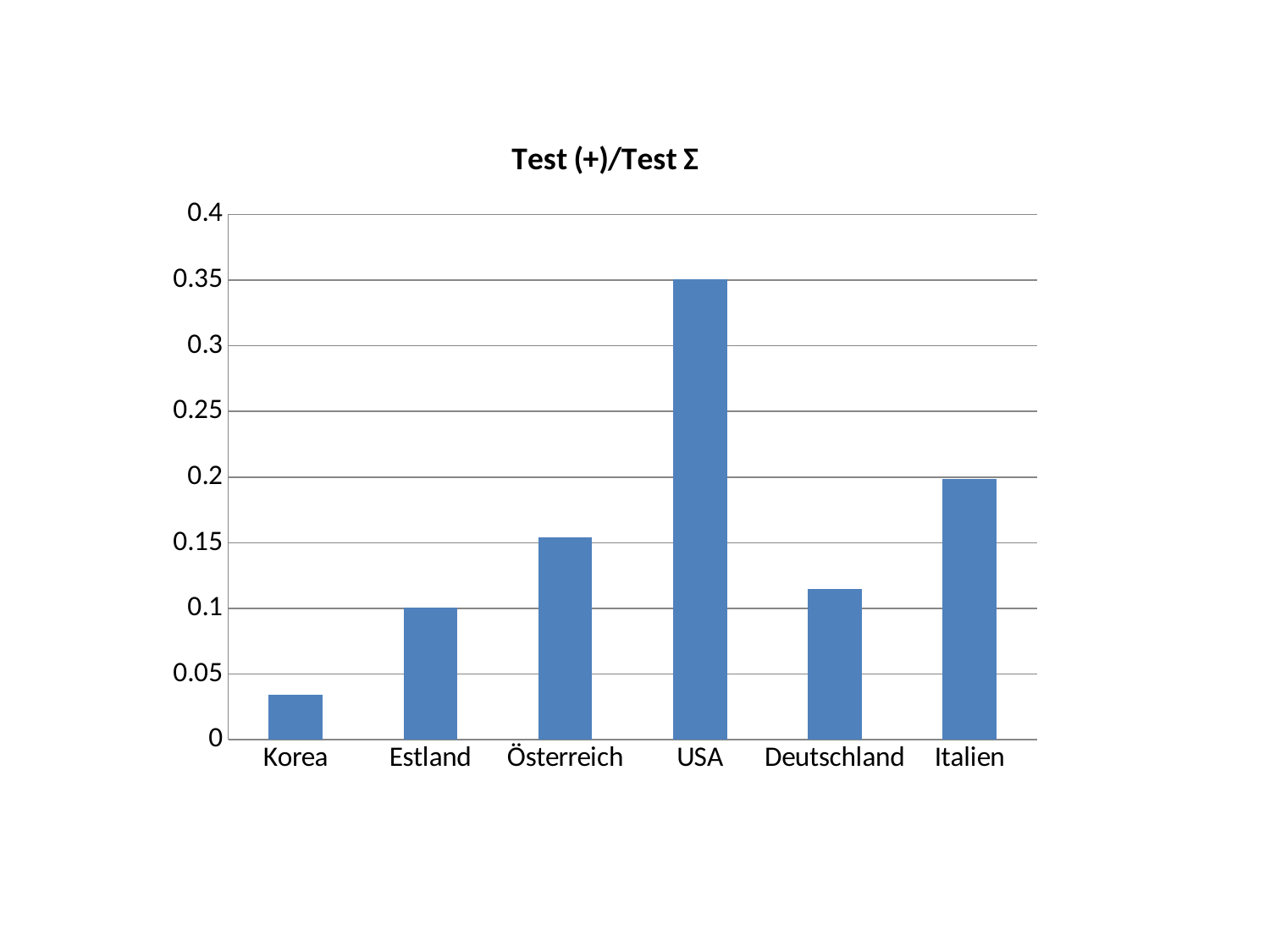
Which has the larger value, Estland or Österreich? Österreich Which country has the highest value in the chart? USA What is the title of the chart? Test (+)/Test Σ How many countries are shown on the x axis of the chart? 6 Is the value for Deutschland greater or less than 0.15? less Is the value for USA greater or less than 0.3? greater Which country has the lowest value in the chart? Korea Is the value for Korea greater or less than 0.05? less Which has the larger value, Italien or Deutschland? Italien What kind of chart is shown on the slide? bar chart What is the highest value shown on the y axis of the chart? 0.4